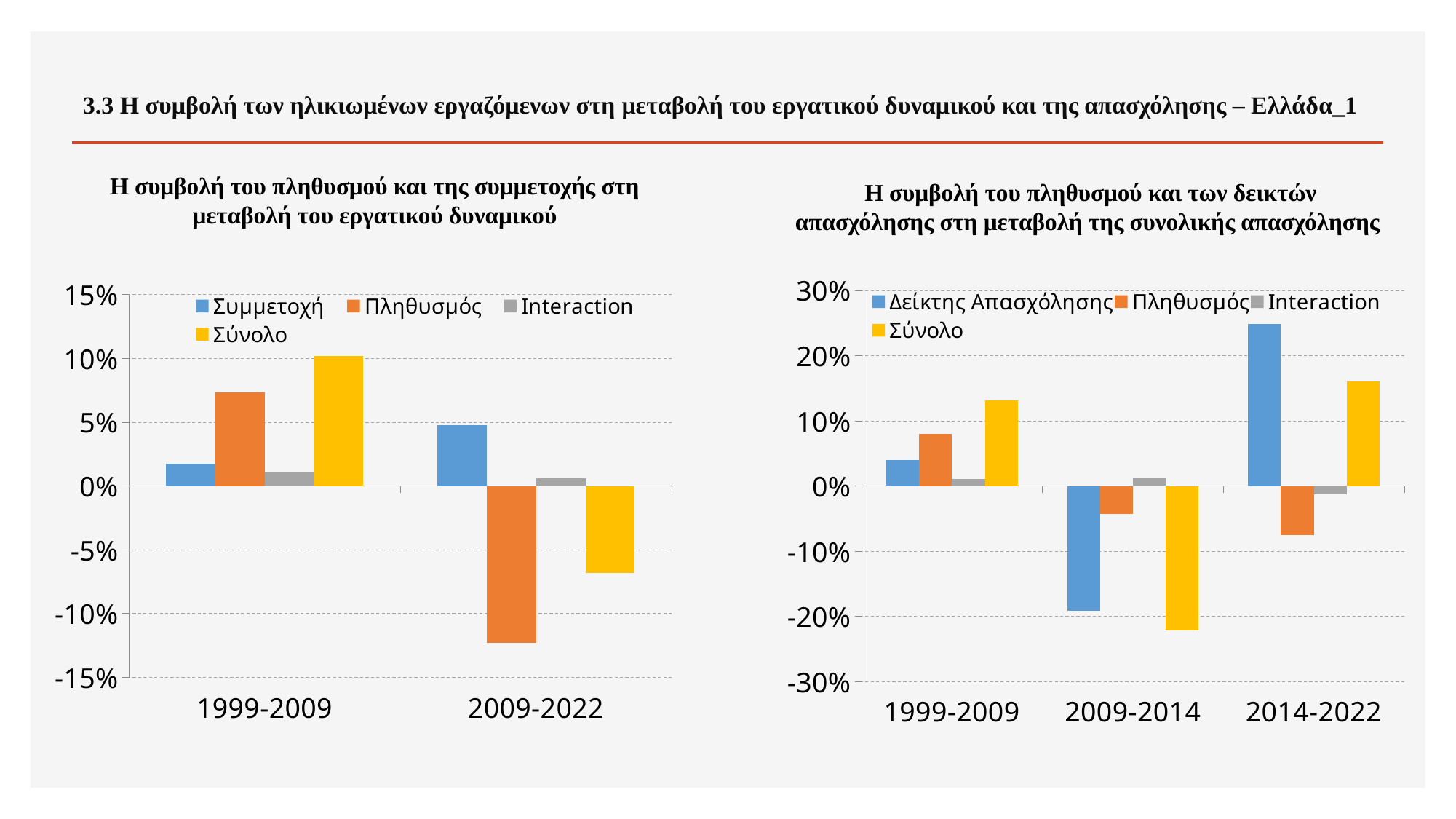
In the right chart, is the value of Σύνολο for 2009-2014 greater or less than -20%? less In the left chart, how many periods are shown on the x axis? 2 In the left chart, is the value of Πληθυσμός for 2009-2022 greater or less than -10%? less What type of chart is the right chart? bar chart In the right chart, how many periods are shown on the x axis? 3 In the right chart, which period has the lowest Σύνολο value? 2009-2014 In the right chart, which is larger for 1999-2009: Πληθυσμός or Δείκτης Απασχόλησης? Πληθυσμός In the left chart, is the value of Σύνολο for 1999-2009 greater or less than 5%? greater In the left chart, which series has the highest value for 1999-2009? Σύνολο In the left chart, how many series does the legend list? 4 In the left chart, which series has the lowest value for 2009-2022? Πληθυσμός